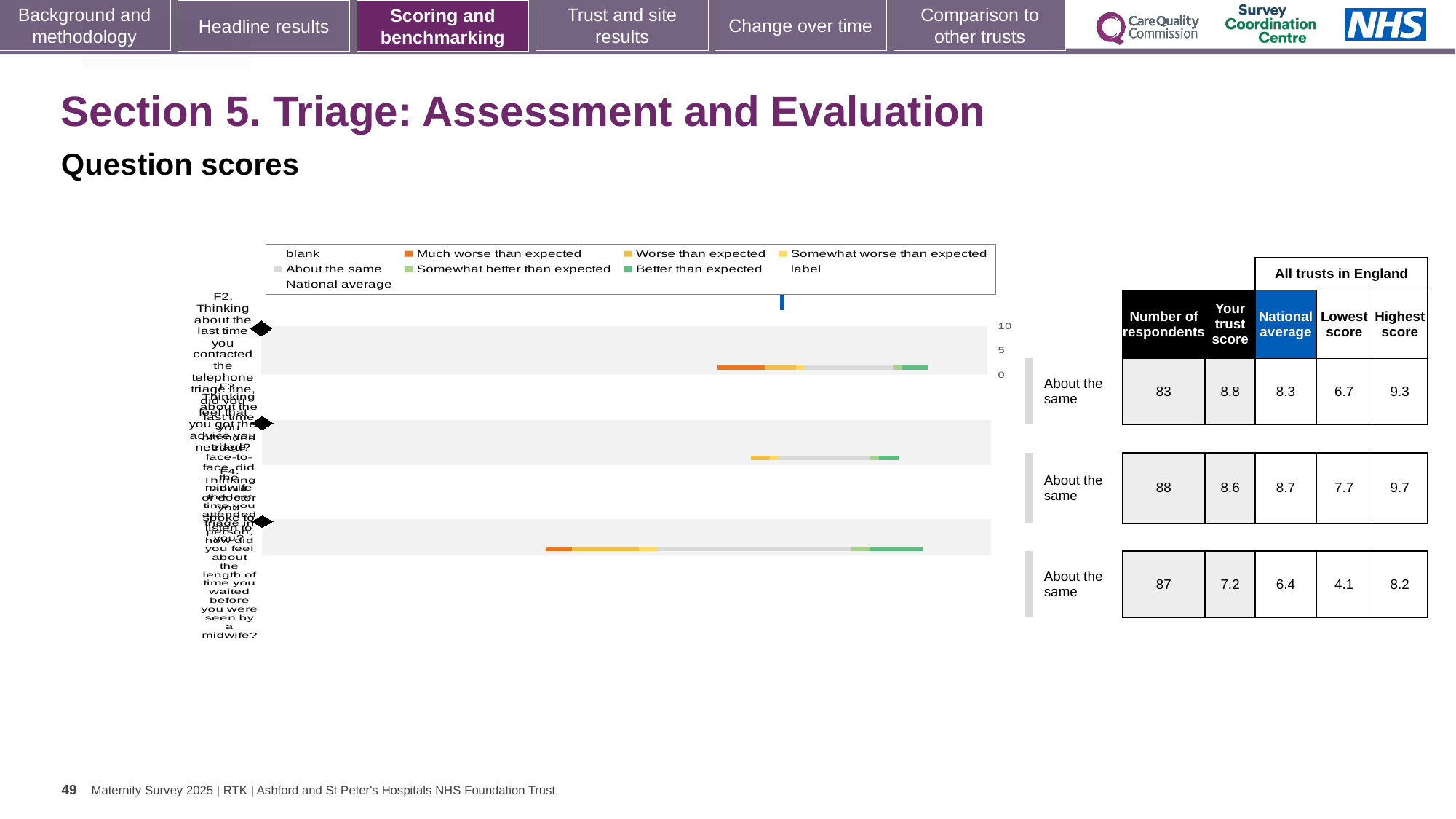
Which row has the lowest 'Lowest score' in the table beside the chart? Third row (F4), 4.1 What benchmark category is shown for all three question rows? About the same In the table beside the chart, what is 'Your trust score' for the third row (F4)? 7.2 For the first row (F2), which is larger: 'Your trust score' or the national average? Your trust score (8.8) In the table beside the chart, what is the national average for the second row (F3)? 8.7 Which row has the highest 'Your trust score' in the table beside the chart? First row (F2), 8.8 How many question rows (F2, F3, F4) are plotted in the chart? 3 For the third row (F4), what is the difference between 'Your trust score' and the national average? 0.8 What heading spans the National average, Lowest score and Highest score columns in the table? All trusts in England In the table beside the chart, what is the highest score for the second row (F3)? 9.7 In the table beside the chart, what is the number of respondents for the first row (F2)? 83 What kind of chart is shown on the slide? bar chart